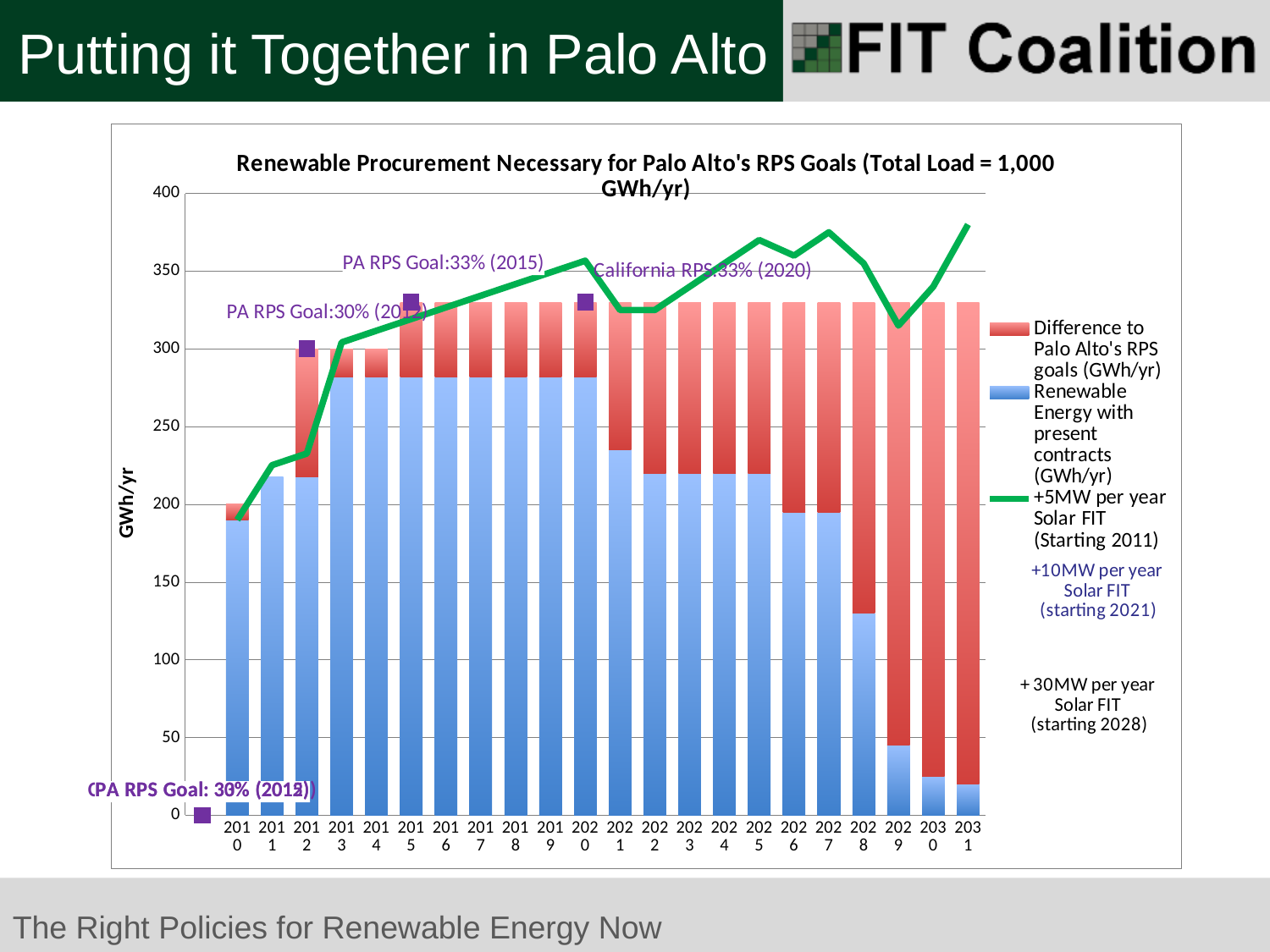
Which is larger, the Renewable Energy with present contracts value for 2011 or for 2028? 2011 Is the value of Renewable Energy with present contracts for 2010 greater or less than 200? less Is the value of the +5MW per year Solar FIT line for 2031 greater or less than 350? greater What kind of chart is shown on the slide? Stacked bar chart with a line What is the label on the vertical axis of the chart? GWh/yr How many years are shown along the x axis of the chart? 22 Is the value of Renewable Energy with present contracts for 2031 greater or less than 50? less What is the title of the chart? Renewable Procurement Necessary for Palo Alto's RPS Goals (Total Load = 1,000 GWh/yr) Which year has the lowest value for Renewable Energy with present contracts? 2031 Do the Renewable Energy with present contracts values rise or fall from 2020 to 2031? fall